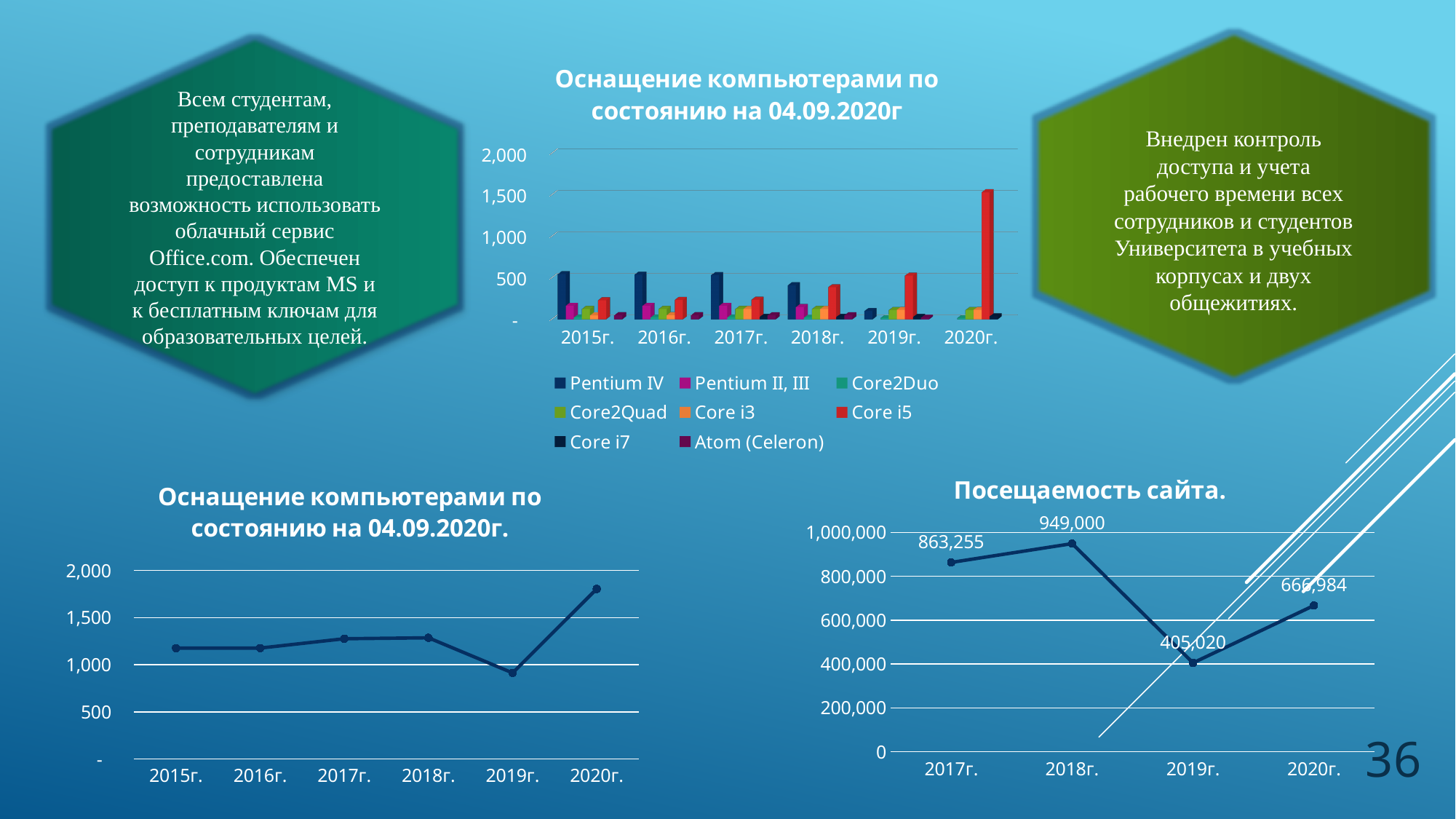
On the top bar chart 'Оснащение компьютерами по состоянию на 04.09.2020г', how many series does the legend list? 8 On the 'Посещаемость сайта.' chart, which year has the highest value? 2018г. On the 'Посещаемость сайта.' chart, what is the value for 2019г.? 405,020 On the 'Посещаемость сайта.' chart, what is the difference between the 2018г. and 2017г. values? 85,745 On the 'Посещаемость сайта.' chart, what is the value for 2018г.? 949,000 On the bottom-left line chart, is the value for 2019г. greater or less than 1,000? less On the 'Посещаемость сайта.' chart, which year has the lowest value? 2019г. On the top bar chart 'Оснащение компьютерами по состоянию на 04.09.2020г', is the value for Core i5 in 2020г. greater or less than 1,000? greater What kind of chart is the bottom-left chart 'Оснащение компьютерами по состоянию на 04.09.2020г.'? line chart On the 'Посещаемость сайта.' chart, which is larger, the value for 2017г. or for 2020г.? 2017г. On the 'Посещаемость сайта.' chart, how many years are plotted? 4 On the top bar chart 'Оснащение компьютерами по состоянию на 04.09.2020г', which series has the highest value in 2020г.? Core i5